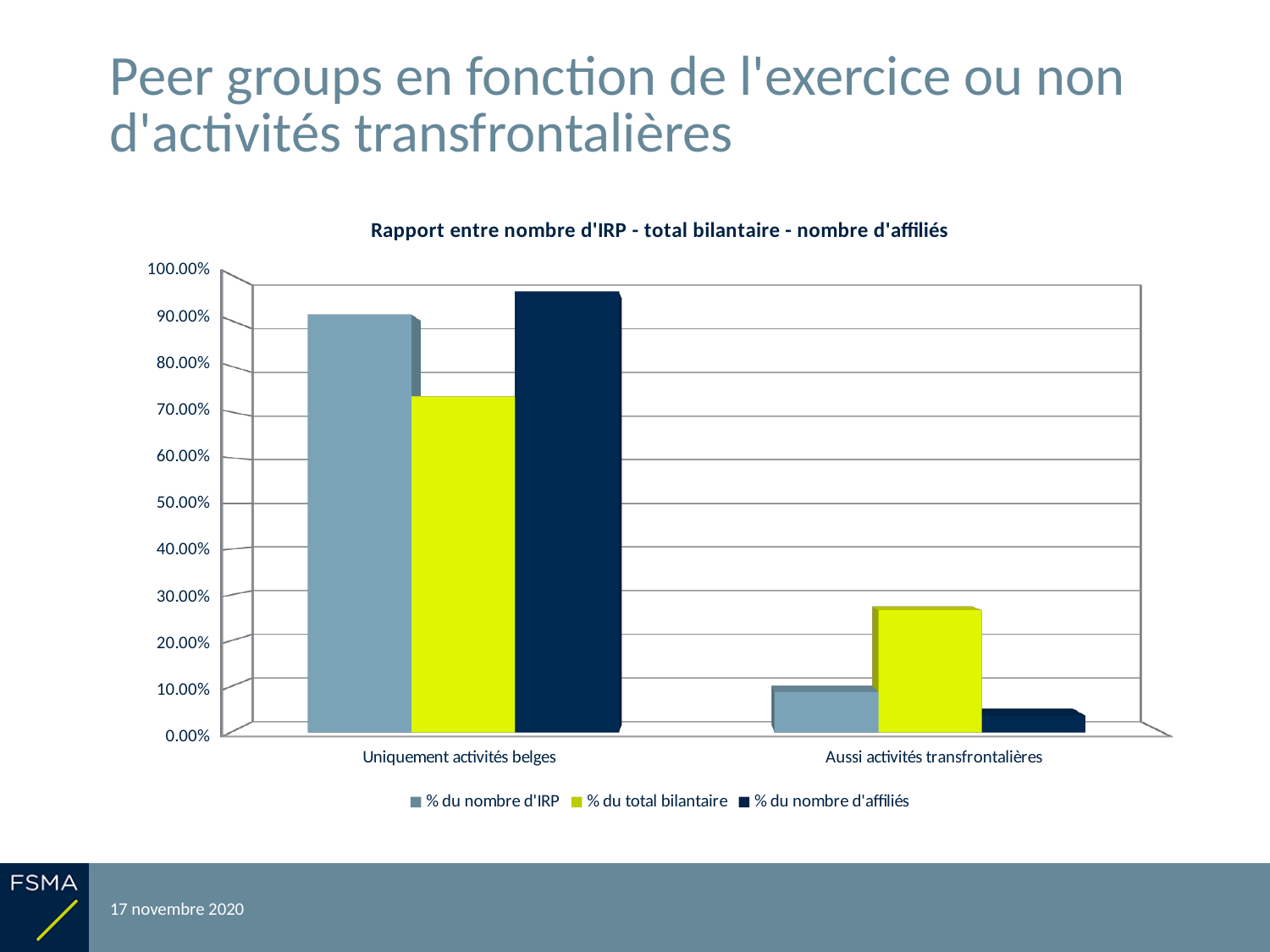
Is the value of '% du nombre d'IRP' for 'Uniquement activités belges' greater or less than 80.00%? greater Which series has the highest value for 'Uniquement activités belges'? % du nombre d'affiliés Is the value of '% du total bilantaire' for 'Aussi activités transfrontalières' greater or less than 20.00%? greater Which series has the lowest value for 'Aussi activités transfrontalières'? % du nombre d'affiliés What kind of chart is shown on the slide? bar chart For 'Aussi activités transfrontalières', which is larger: '% du nombre d'IRP' or '% du total bilantaire'? % du total bilantaire How many series does the chart legend list? 3 What is the title of the chart? Rapport entre nombre d'IRP - total bilantaire - nombre d'affiliés How many categories are shown on the x axis of the chart? 2 Which series has the highest value for 'Aussi activités transfrontalières'? % du total bilantaire Which series has the lowest value for 'Uniquement activités belges'? % du total bilantaire Is the value of '% du total bilantaire' for 'Uniquement activités belges' greater or less than 80.00%? less